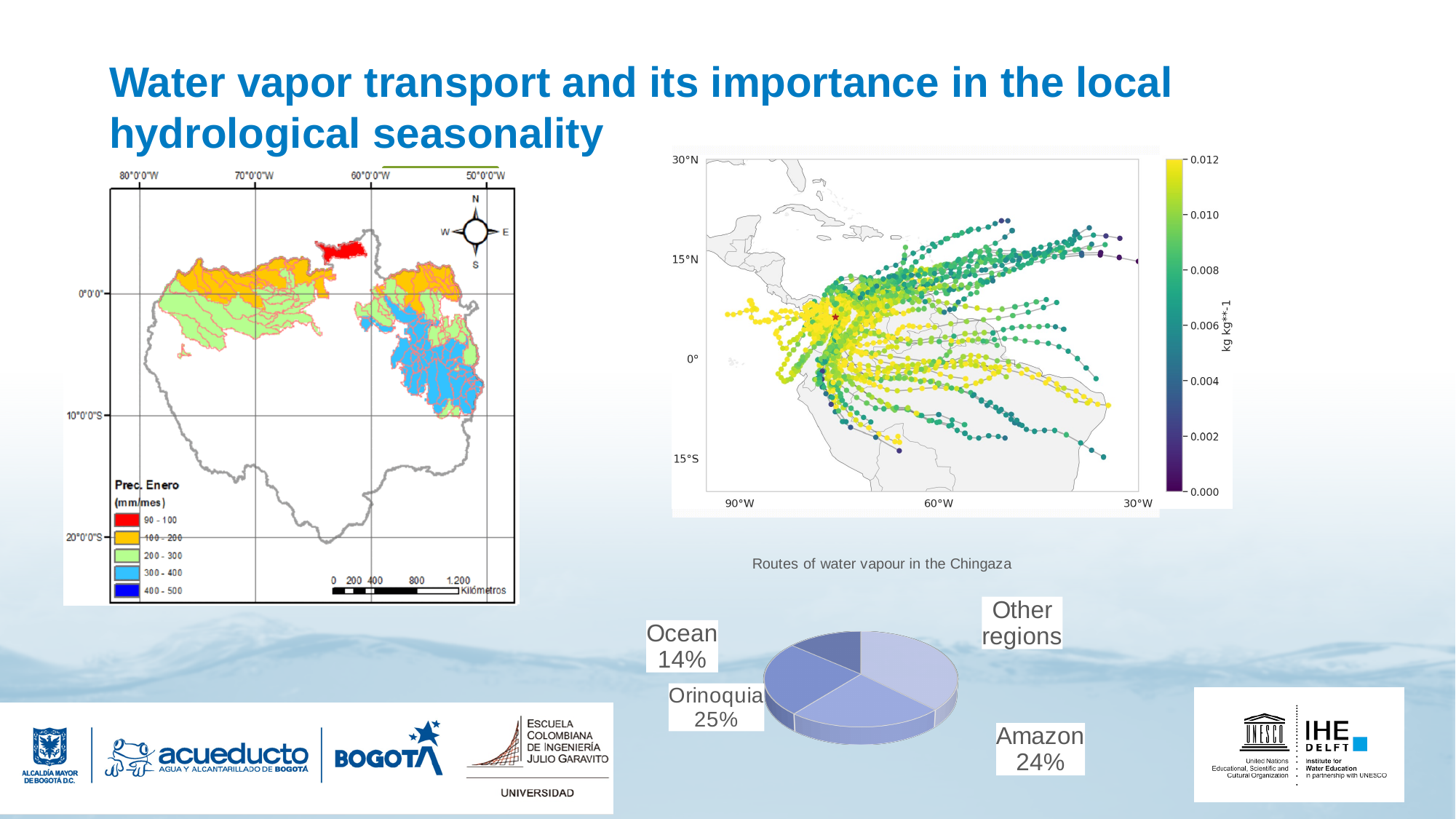
In the pie chart at the bottom of the slide, what share does Ocean have? 14% In the pie chart at the bottom of the slide, what share does Orinoquia have? 25% In the pie chart at the bottom of the slide, is the Ocean share greater or less than 20%? less What is the caption of the map chart on the right of the slide? Routes of water vapour in the Chingaza What kind of chart is shown at the bottom of the slide with the Ocean, Orinoquia and Amazon labels? Pie chart What is the maximum value shown on the colour bar of the map chart on the right of the slide? 0.012 In the pie chart at the bottom of the slide, what is the difference between the Orinoquia share and the Ocean share? 11% In the pie chart at the bottom of the slide, what share does Amazon have? 24% In the pie chart at the bottom of the slide, which is larger, the Ocean slice or the Other regions slice? Other regions In the pie chart at the bottom of the slide, which slice is the smallest? Ocean In the pie chart at the bottom of the slide, which slice is the largest? Other regions In the pie chart at the bottom of the slide, how many slices are there? 4